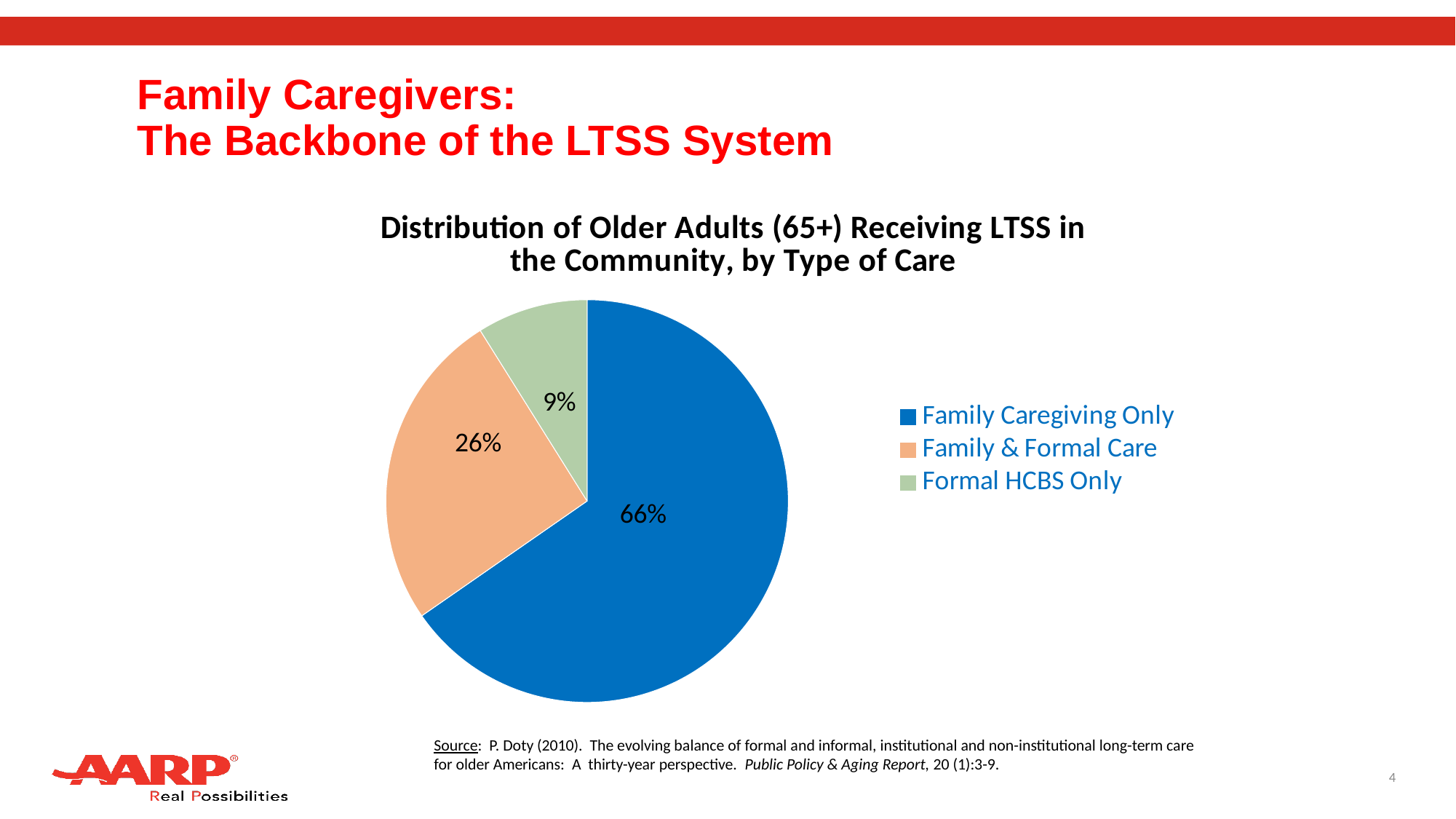
Which type of care accounts for the largest slice of the pie? Family Caregiving Only What share of older adults receiving LTSS in the community receive Formal HCBS Only? 9% What share of older adults receiving LTSS in the community receive Family & Formal Care? 26% How many categories does the pie chart show? 3 What kind of chart is shown on the slide? Pie chart Which colour represents Formal HCBS Only in the pie chart? Green What is the difference in percentage points between Family Caregiving Only and Family & Formal Care? 40 What is the difference in percentage points between Family & Formal Care and Formal HCBS Only? 17 What share of older adults receiving LTSS in the community receive Family Caregiving Only? 66% Which is larger: the share for Family & Formal Care or the share for Formal HCBS Only? Family & Formal Care Which type of care accounts for the smallest slice of the pie? Formal HCBS Only What is the title of the chart? Distribution of Older Adults (65+) Receiving LTSS in the Community, by Type of Care